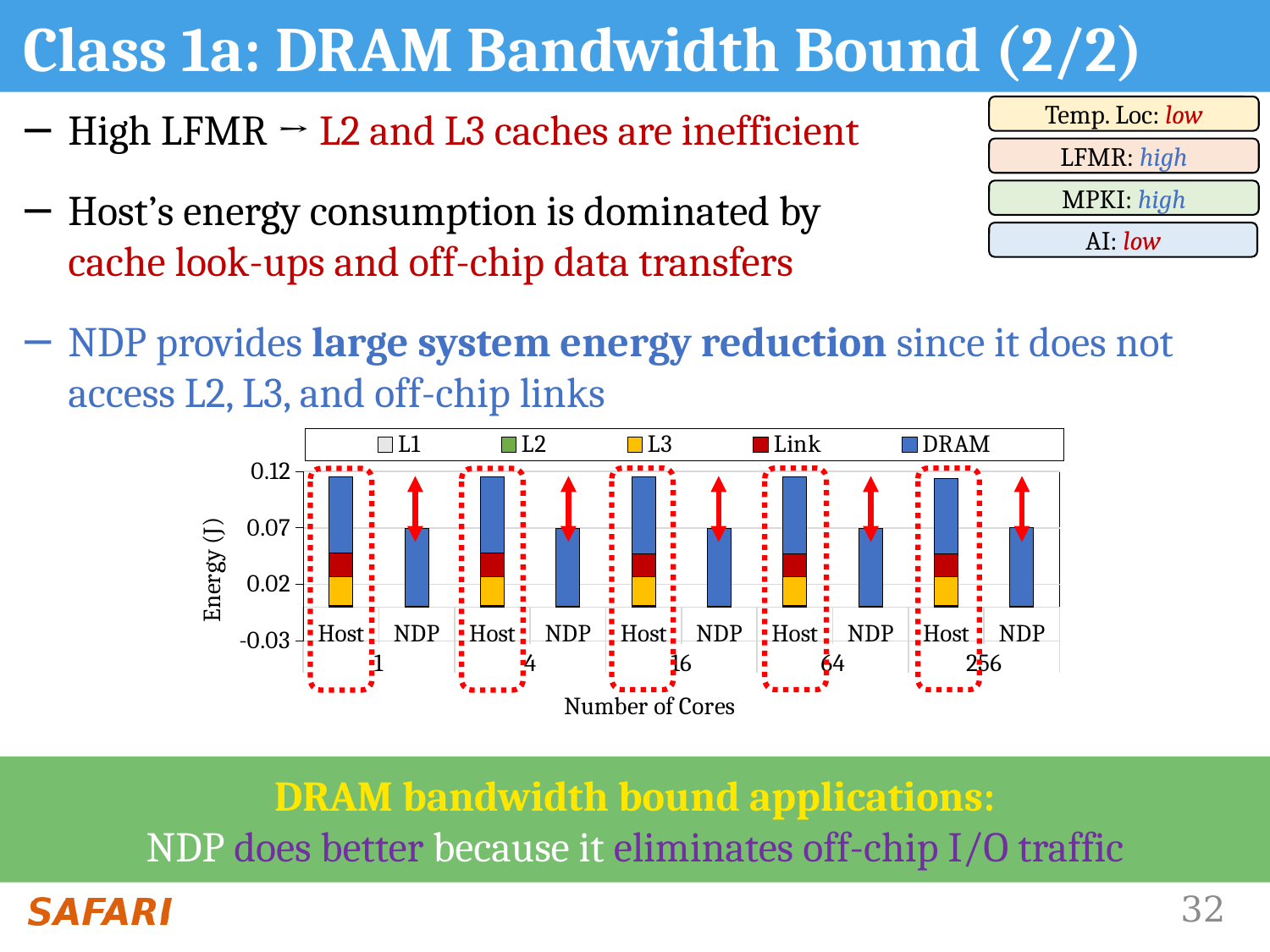
Is the total energy for Host at 1 core greater or less than 0.07? greater Is the total energy for Host at 64 cores greater or less than 0.02? greater Does the total energy of the Host bars rise, fall, or stay roughly constant as the number of cores increases? stays roughly constant What is the title of the x axis of the chart? Number of Cores Which core counts are shown along the x axis of the chart? 1, 4, 16, 64, 256 What kind of chart is shown on the slide? stacked bar chart How many series does the chart's legend list? 5 At 16 cores, which has the larger total energy, Host or NDP? Host Is the total energy for NDP at 256 cores greater or less than 0.12? less Which series appears in the NDP bars? DRAM How many bars are plotted in the chart? 10 At 4 cores, which has the smaller total energy, Host or NDP? NDP